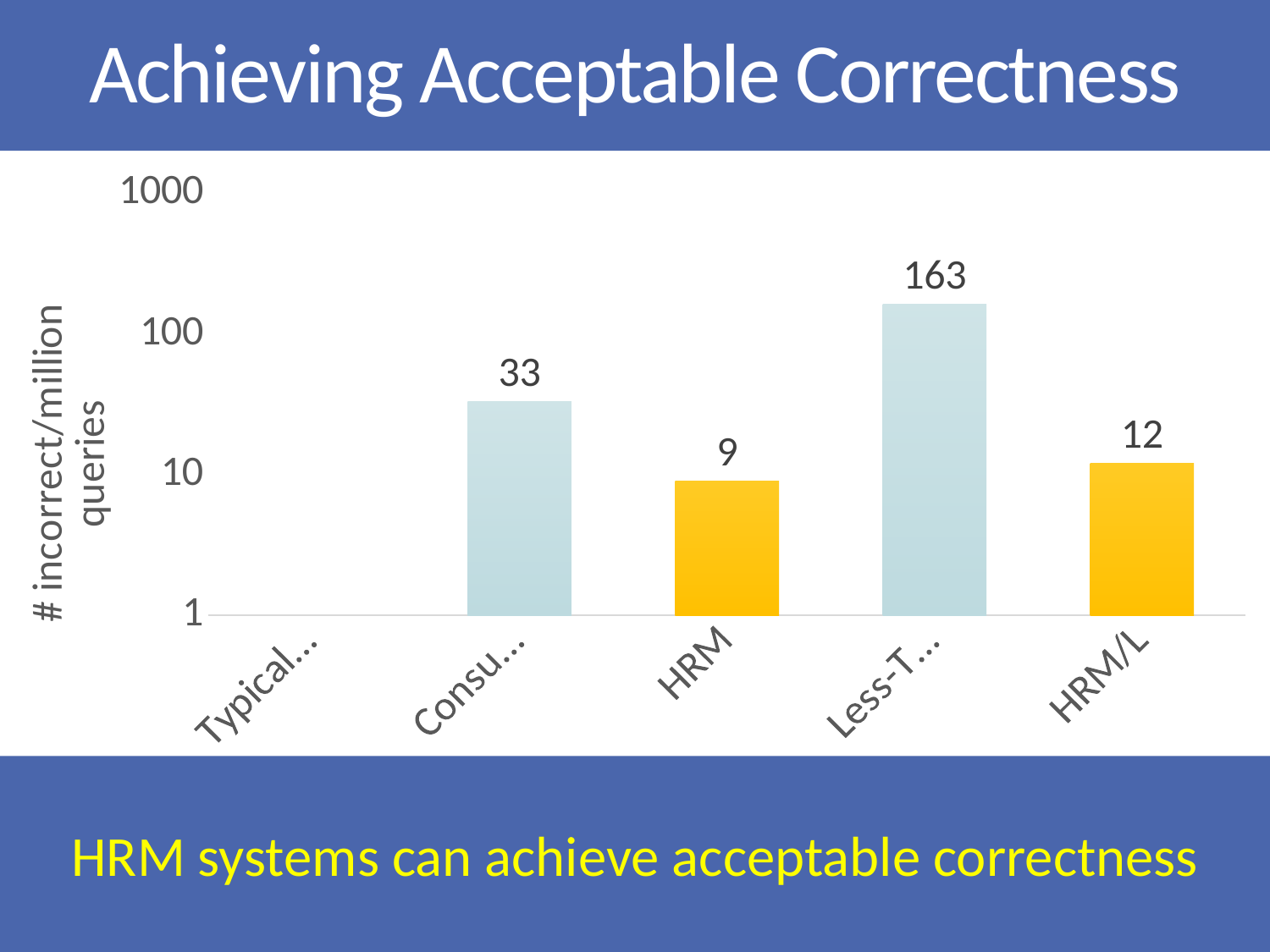
What is the value for HRM/L? 12 How many category labels are shown on the x axis? 5 What is the difference between the tallest bar (163) and the second bar from the left (33)? 130 What is the difference between the value for HRM/L and the value for HRM? 3 Which bar has the highest value? the fourth bar from the left (163) Is the value for HRM greater or less than 10? less What is the value shown on the fourth bar from the left (the tallest bar)? 163 What kind of chart is shown on the slide? bar chart What is the value for HRM? 9 What is the value shown on the second bar from the left? 33 What is the title of the y axis? # incorrect/million queries Which is larger, the value for HRM or the value for HRM/L? HRM/L